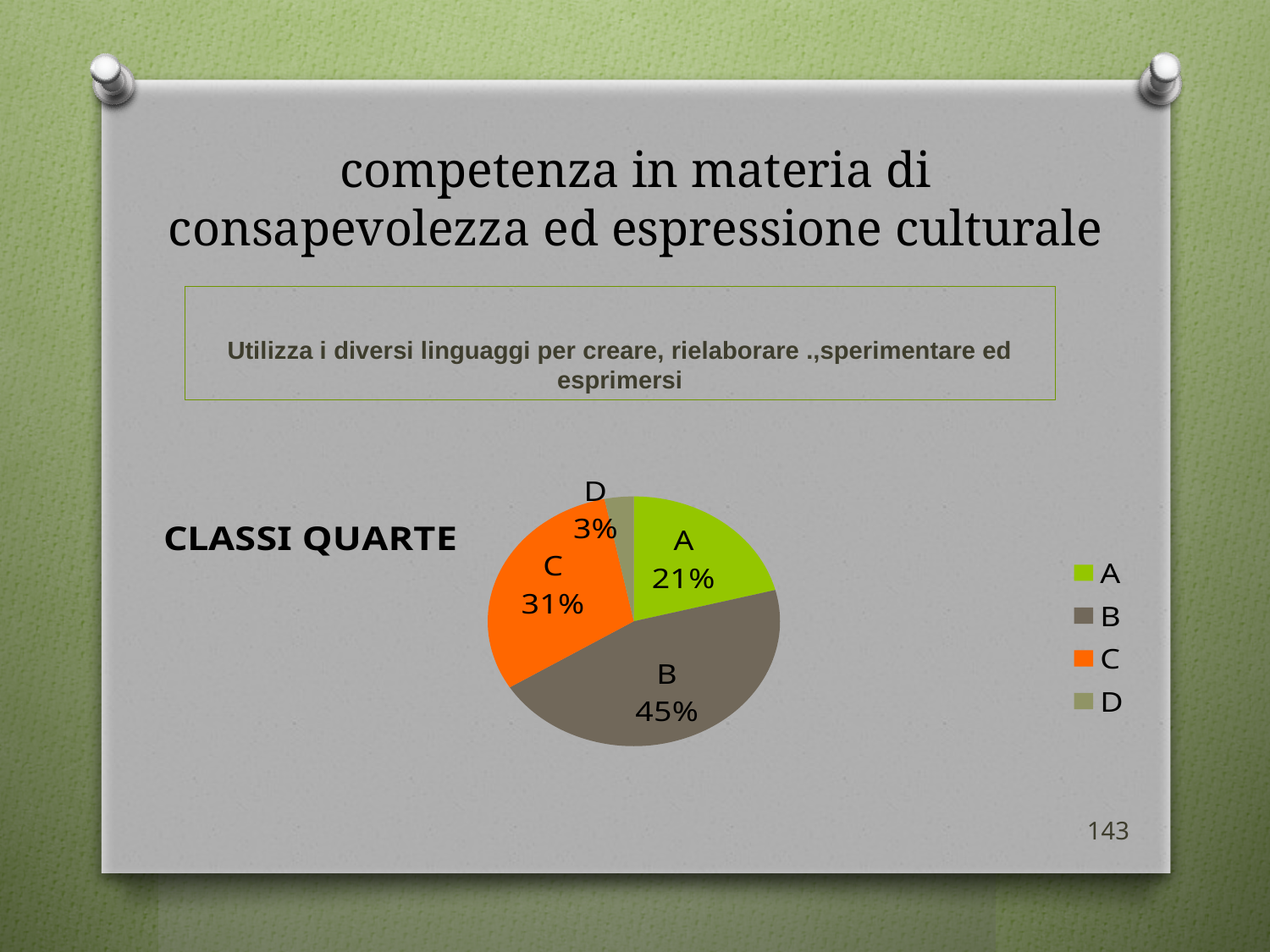
What percentage does slice B represent in the pie chart? 45% Which category has the smallest share of the pie chart? D What colour is slice C in the pie chart? orange How many entries does the legend list? 4 Which is larger, the share for A or the share for C? C How many slices does the pie chart have? 4 Which category has the largest share of the pie chart? B What percentage does slice C represent in the pie chart? 31% What percentage does slice D represent in the pie chart? 3% What percentage does slice A represent in the pie chart? 21% What kind of chart is shown on the slide? pie chart What is the difference in percentage points between slice B and slice C? 14